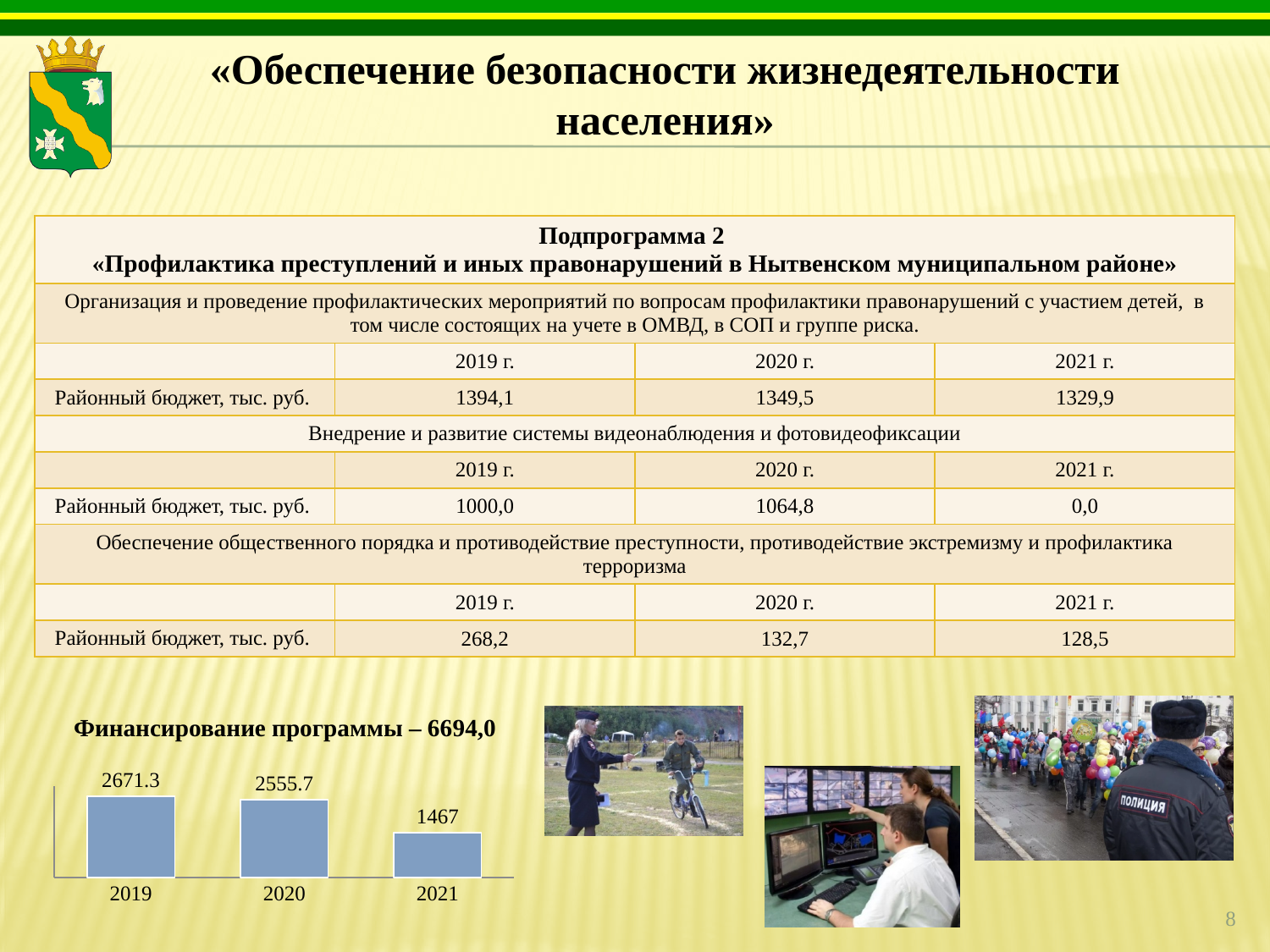
What is the value shown for 2020 in the bar chart? 2555.7 What is the value shown for 2021 in the bar chart? 1467 Do the values in the bar chart rise or fall from 2019 to 2021? Fall What is the difference between the values for 2020 and 2021 in the bar chart? 1088.7 What is the value shown for 2019 in the bar chart? 2671.3 Which year has the highest value in the bar chart? 2019 What is the difference between the values for 2019 and 2020 in the bar chart? 115.6 What is the title shown above the bar chart? Финансирование программы – 6694,0 What type of chart is shown at the bottom left of the slide? Bar chart Which is larger in the bar chart, the value for 2020 or the value for 2021? 2020 How many bars are shown in the bar chart? 3 Which year has the lowest value in the bar chart? 2021